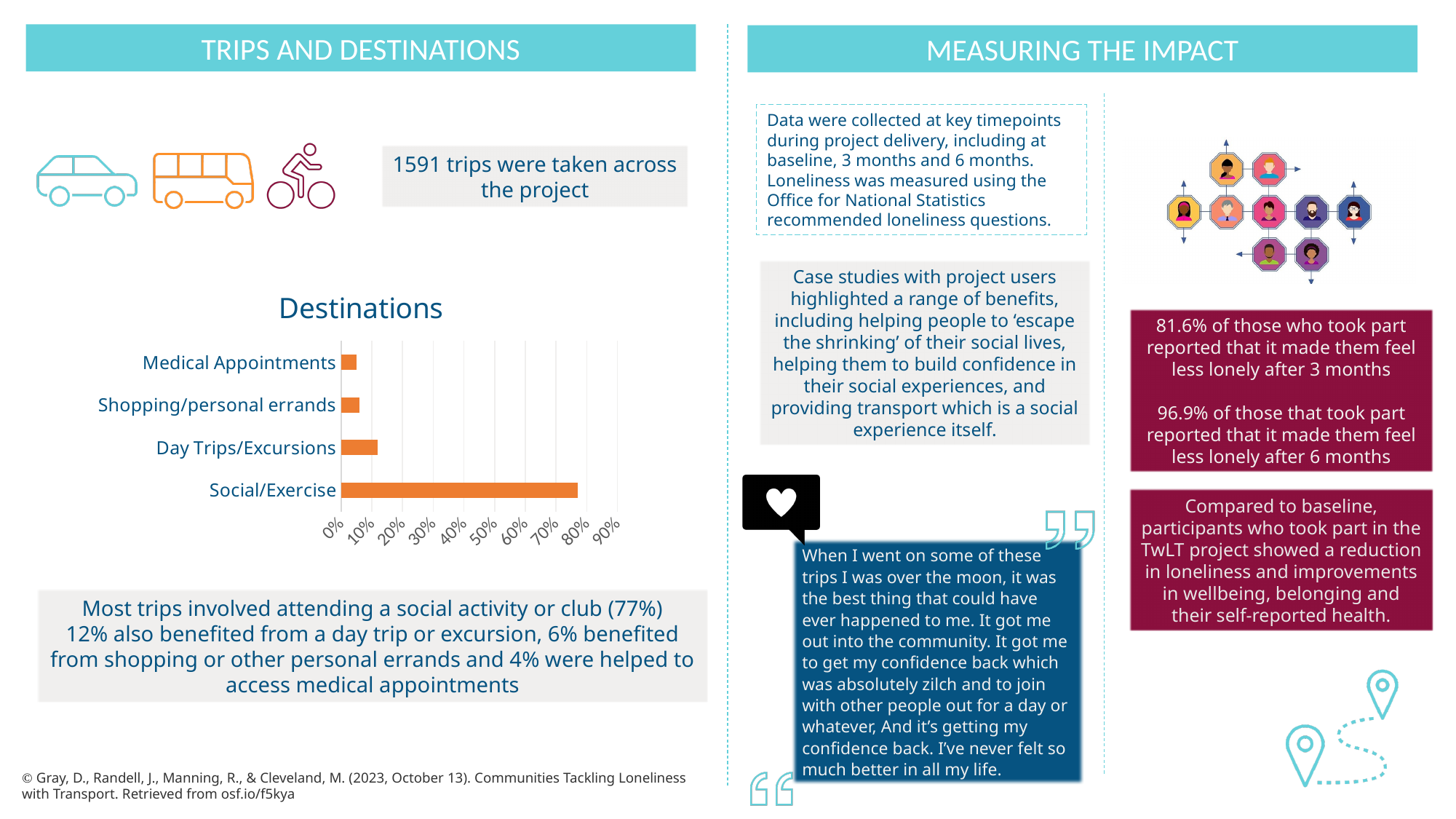
What is the highest value shown on the x axis of the Destinations chart? 90% What is the title of the bar chart on the slide? Destinations Which category has the lowest value in the Destinations chart? Medical Appointments In the Destinations chart, is the value for Social/Exercise greater or less than 70%? greater In the Destinations chart, is the value for Shopping/personal errands greater or less than 10%? less According to the slide, what percentage of trips involved attending a social activity or club? 77% According to the slide, what percentage of trips were day trips or excursions? 12% What type of chart is the Destinations chart? bar chart In the Destinations chart, which is larger: Day Trips/Excursions or Shopping/personal errands? Day Trips/Excursions In the Destinations chart, is the value for Day Trips/Excursions greater or less than 20%? less How many categories are shown in the Destinations chart? 4 Which category has the highest value in the Destinations chart? Social/Exercise